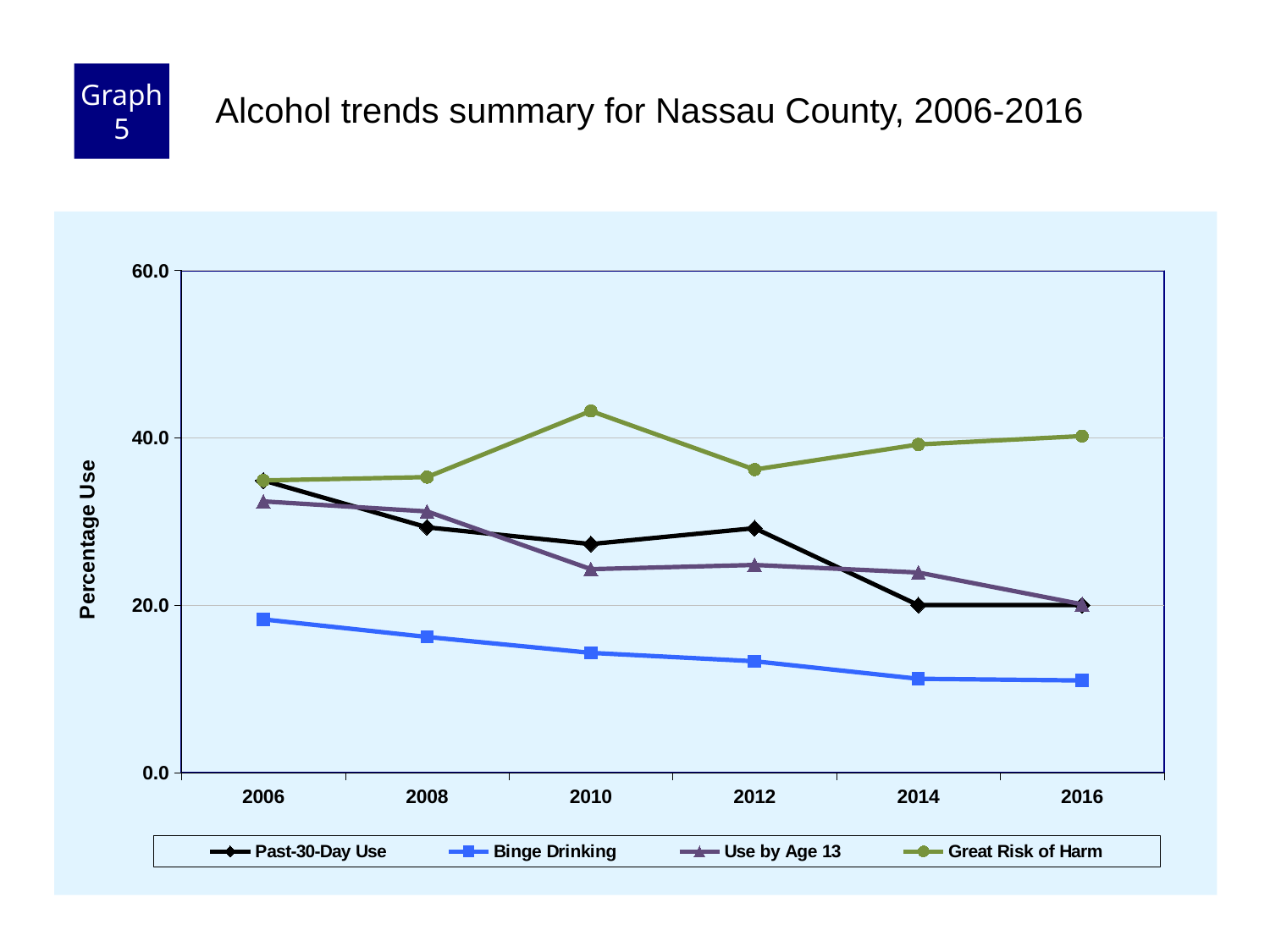
Which series has the lowest value in 2010? Binge Drinking What is the label on the y axis? Percentage Use In 2012, which is larger: Past-30-Day Use or Use by Age 13? Past-30-Day Use Is the value for Binge Drinking in 2006 greater or less than 20.0? less In which year does the Great Risk of Harm series reach its highest value? 2010 What kind of chart is shown on the slide? line chart How many years are plotted along the x axis? 6 Is the value for Great Risk of Harm in 2010 greater or less than 40.0? greater What is the title of the slide's chart? Alcohol trends summary for Nassau County, 2006-2016 Does the Binge Drinking series rise or fall from 2006 to 2016? fall Which series has the highest value in 2016? Great Risk of Harm How many series does the legend list? 4